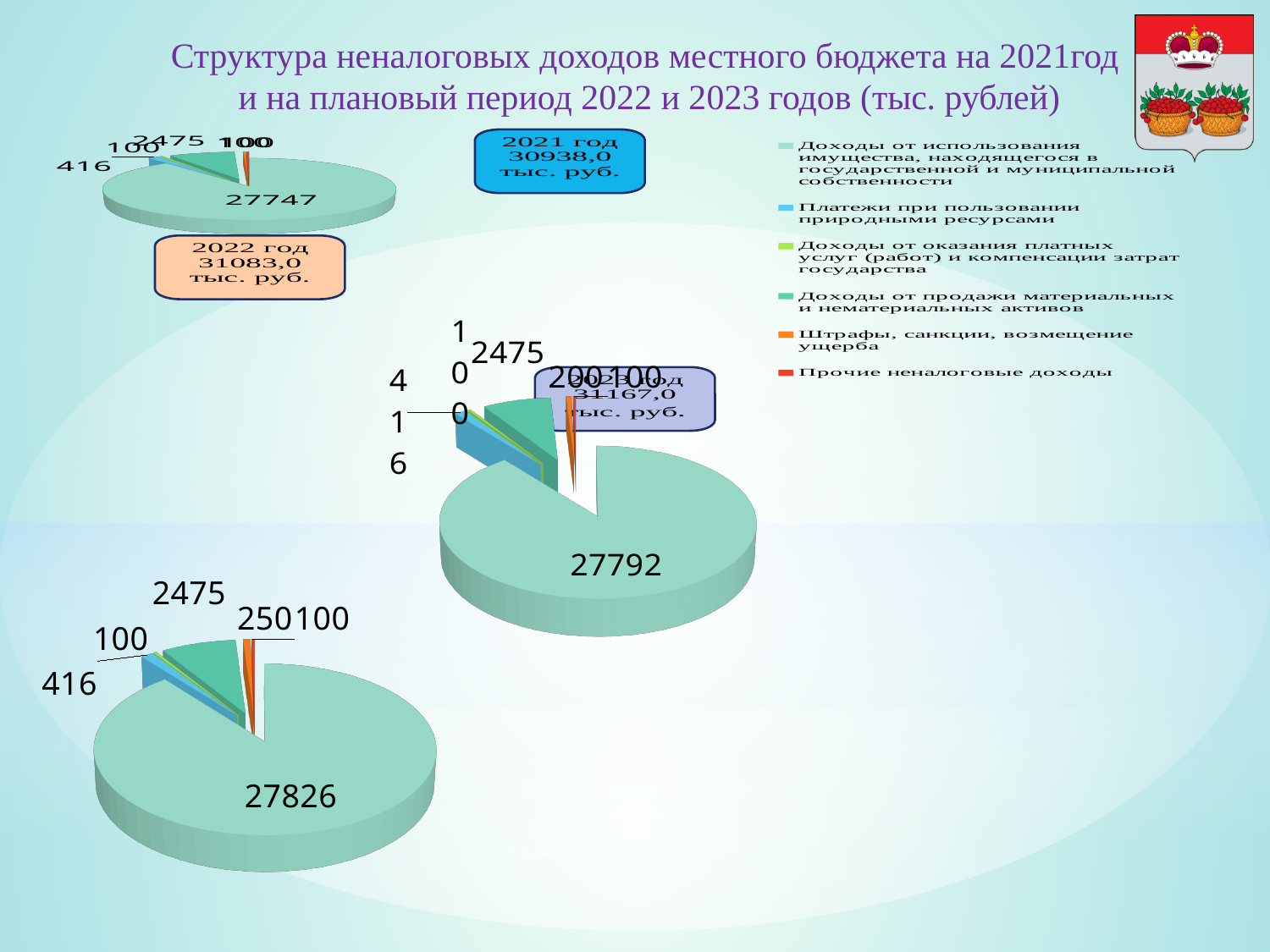
How many charts are shown on the slide? 3 In the bottom-left pie chart, which is larger: the slice labelled 2475 or the slice labelled 416? 2475 What is the difference between the largest slice of the bottom-left pie chart (27826) and the largest slice of the top-left pie chart (27747)? 79 What is the total of all slice values in the bottom-left pie chart? 31167 In the top-left pie chart, what is the value of the largest slice? 27747 In the bottom-left pie chart, what is the difference between the slice labelled 2475 and the slice labelled 416? 2059 In the bottom-left pie chart, what is the value of the orange slice? 250 In the bottom-left pie chart, what is the value of the largest slice? 27826 In the middle pie chart, what is the value of the largest slice? 27792 What kind of chart is the bottom-left chart on the slide? pie chart How many entries does the legend on the right list? 6 In the bottom-left pie chart, what is the value of the blue slice? 416